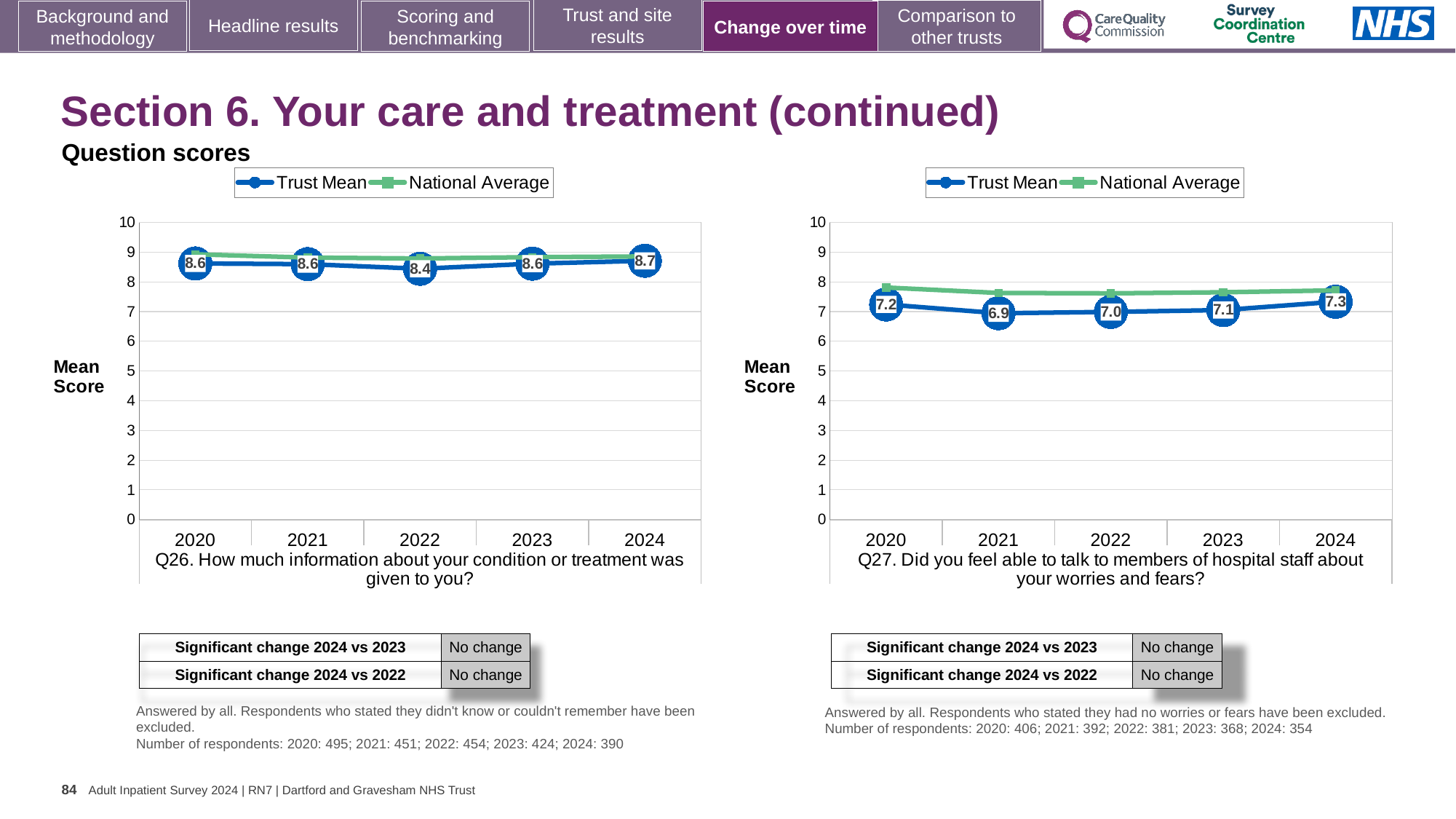
How many years are plotted on the x axis of the Q26 chart (left)? 5 In the Q26 chart (left), which year has the lowest Trust Mean score? 2022 In the Q27 chart (right), is the Trust Mean score for 2020 or 2021 larger? 2020 In the Q27 chart (right), what is the Trust Mean score for 2021? 6.9 In the Q26 chart (left), what is the difference between the Trust Mean scores for 2024 and 2022? 0.3 In the Q27 chart (right), which year has the highest Trust Mean score? 2024 In the Q26 chart (left), what is the Trust Mean score for 2024? 8.7 In the Q27 chart (right), what is the Trust Mean score for 2024? 7.3 In the Q27 chart (right), is the National Average for 2020 greater or less than 7? greater What type of chart is the Q27 chart (right)? Line chart In the Q26 chart (left), what is the Trust Mean score for 2022? 8.4 In the Q27 chart (right), which year has the lowest Trust Mean score? 2021